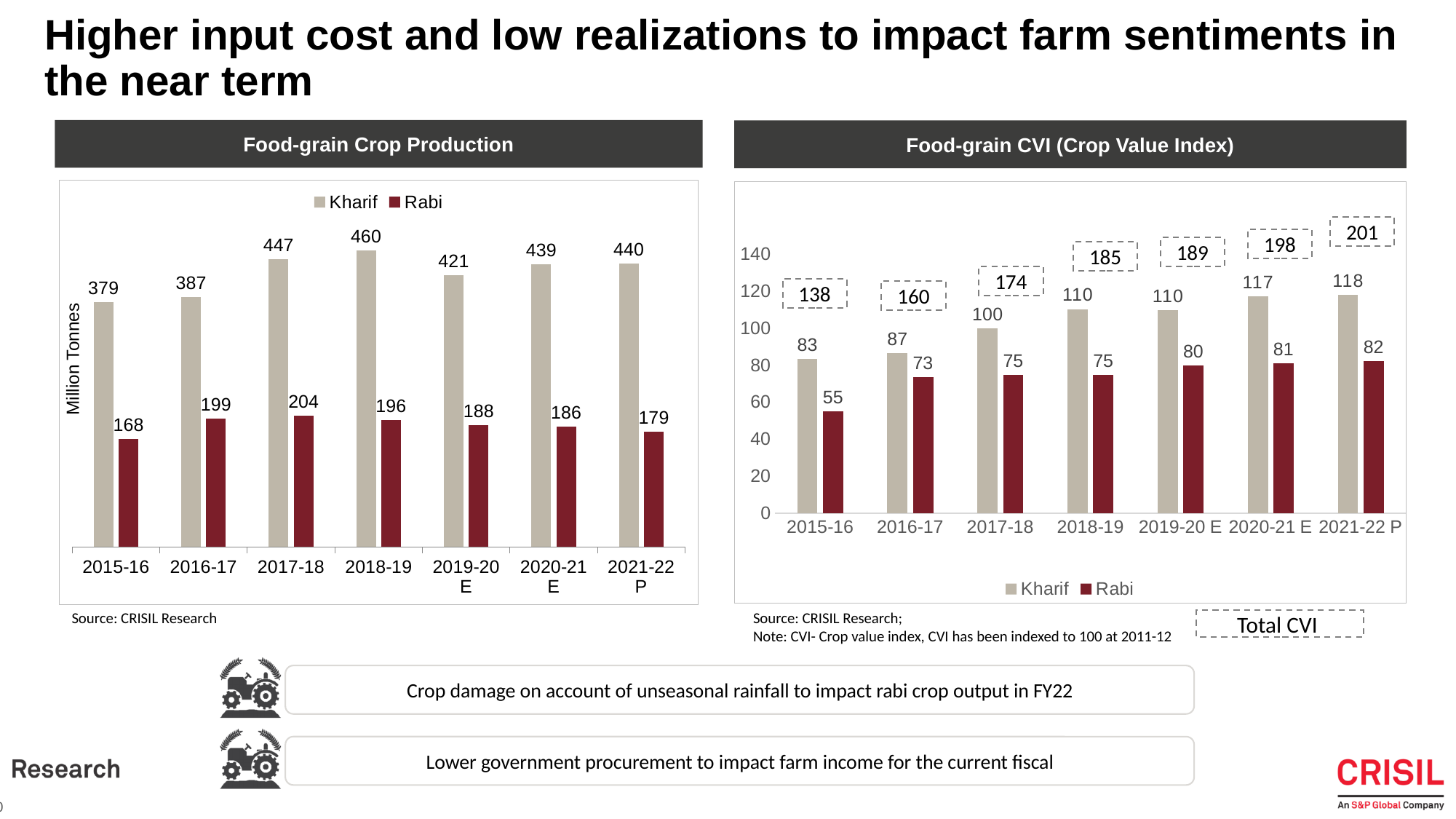
In the Food-grain Crop Production chart, what is the Rabi value for 2015-16? 168 In the Food-grain CVI (Crop Value Index) chart, do the Total CVI values rise or fall from 2015-16 to 2021-22 P? rise In the Food-grain Crop Production chart, what is the Kharif value for 2018-19? 460 In the Food-grain Crop Production chart, which year has the lowest Rabi value? 2015-16 In the Food-grain CVI (Crop Value Index) chart, what is the Kharif value for 2017-18? 100 In the Food-grain Crop Production chart, what is the difference between the Kharif and Rabi values for 2021-22 P? 261 In the Food-grain CVI (Crop Value Index) chart, is the Kharif value for 2020-21 E greater or less than 100? greater How many series does the legend of the Food-grain CVI (Crop Value Index) chart list? 2 In the Food-grain CVI (Crop Value Index) chart, which year has the lowest Rabi value? 2015-16 In the Food-grain CVI (Crop Value Index) chart, what is the Total CVI for 2021-22 P? 201 In the Food-grain Crop Production chart, which year has the highest Kharif value? 2018-19 In the Food-grain Crop Production chart, how many years are shown on the x axis? 7